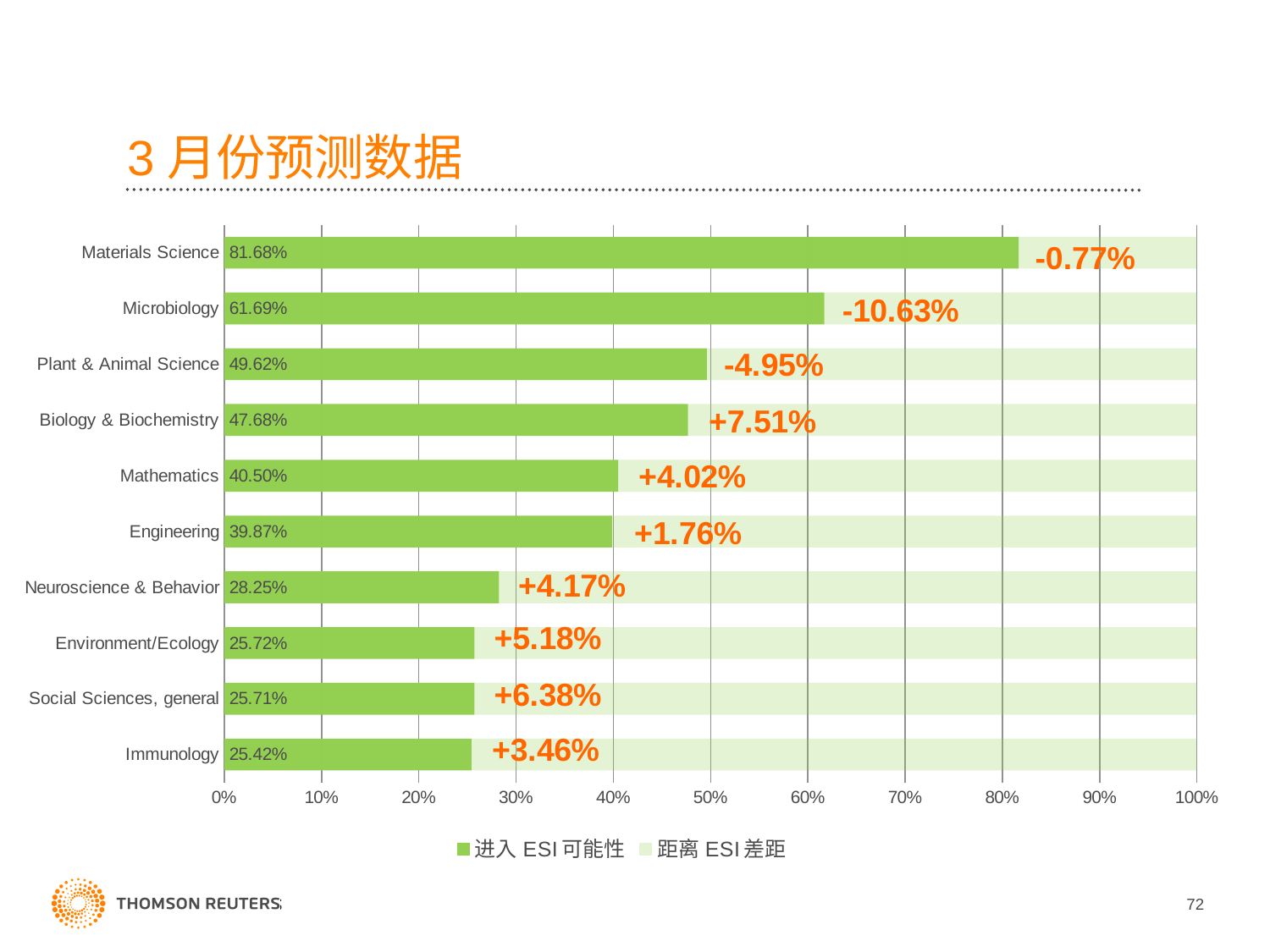
What kind of chart is shown on the slide? Stacked bar chart What is the difference between the 进入 ESI 可能性 values for Materials Science and Microbiology? 19.99% Is the 进入 ESI 可能性 value for Biology & Biochemistry greater or less than 50%? less How many categories are shown on the chart? 10 Which has a larger 进入 ESI 可能性 value, Plant & Animal Science or Engineering? Plant & Animal Science What orange change value is shown next to the Microbiology bar? -10.63% Which category has the highest 进入 ESI 可能性 value? Materials Science Which category has the lowest 进入 ESI 可能性 value? Immunology What is the 进入 ESI 可能性 value for Mathematics? 40.50% What is the 进入 ESI 可能性 value for Materials Science? 81.68% How many series does the legend list? 2 What is the 进入 ESI 可能性 value for Immunology? 25.42%